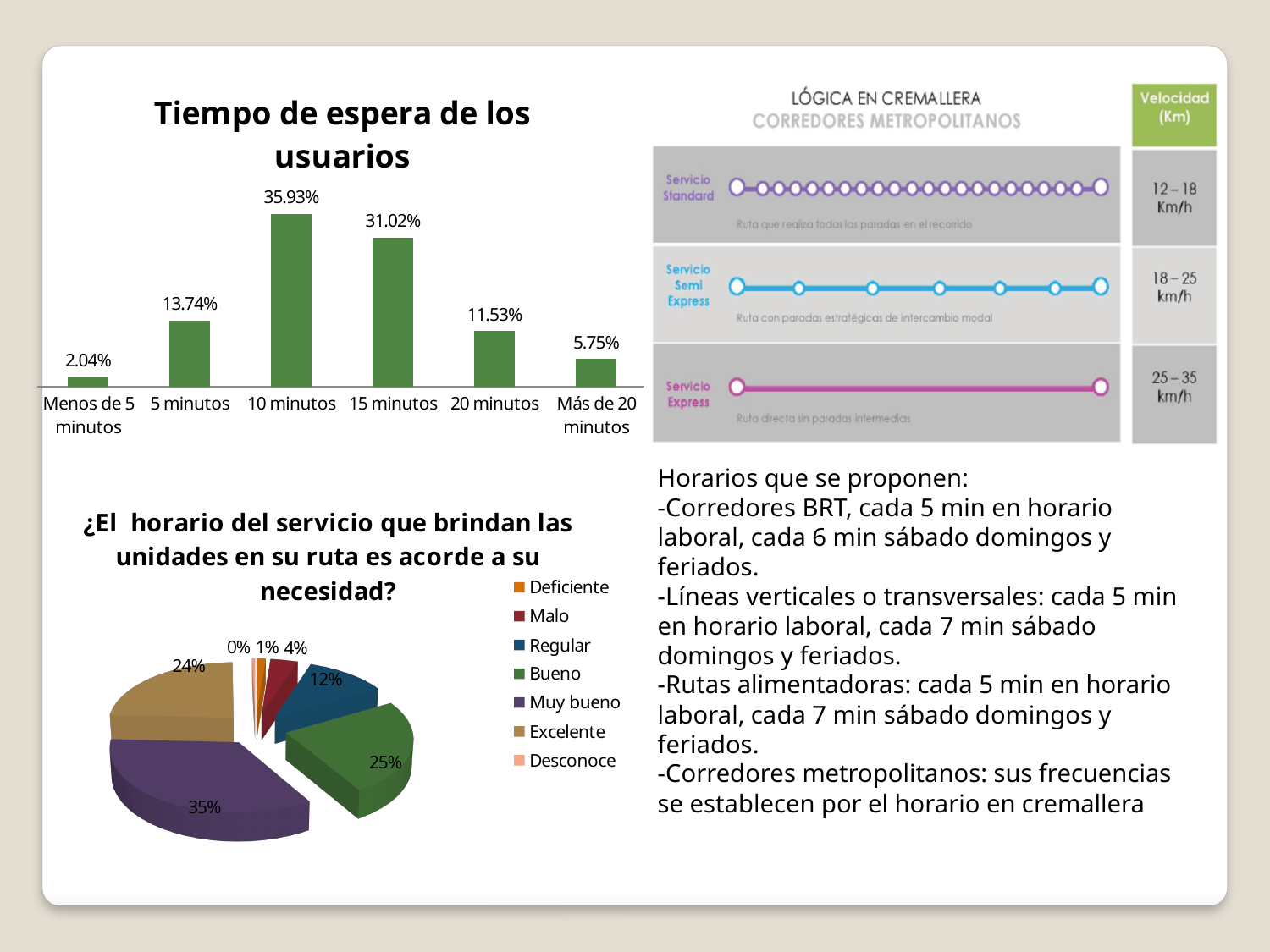
In the pie chart about whether the service schedule meets users' needs, what share does 'Bueno' have? 25% In the 'Tiempo de espera de los usuarios' chart, which category has the highest value? 10 minutos In the 'Tiempo de espera de los usuarios' chart, what is the difference between the values for '10 minutos' and '15 minutos'? 4.91% What kind of chart is 'Tiempo de espera de los usuarios'? Bar chart In the 'Tiempo de espera de los usuarios' chart, what is the value for 'Menos de 5 minutos'? 2.04% In the pie chart about whether the service schedule meets users' needs, which category has the largest slice? Muy bueno In the 'Tiempo de espera de los usuarios' chart, which category has the lowest value? Menos de 5 minutos How many entries does the legend of the pie chart about the service schedule list? 7 In the 'Tiempo de espera de los usuarios' chart, what is the value for '10 minutos'? 35.93% In the 'Tiempo de espera de los usuarios' chart, which is larger: the value for '5 minutos' or for '20 minutos'? 5 minutos How many categories are shown in the 'Tiempo de espera de los usuarios' chart? 6 In the pie chart about whether the service schedule meets users' needs, what share does 'Muy bueno' have? 35%